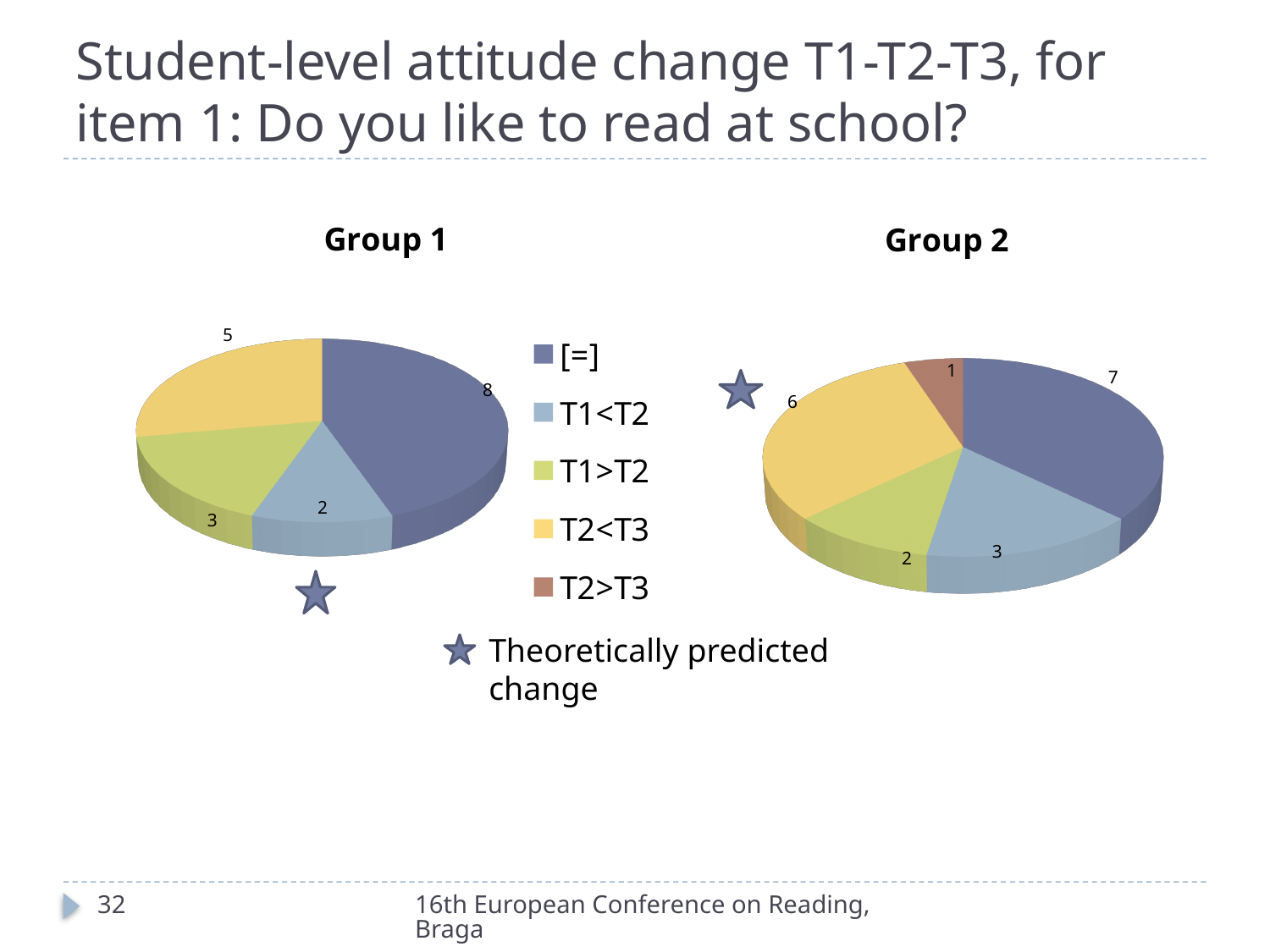
In the Group 1 chart, what is the value for T2<T3? 5 Which is larger: the T2<T3 value in Group 1 or the T2<T3 value in Group 2? Group 2 How many slices does the Group 2 pie chart have? 5 In the Group 2 chart, which category has the smallest slice? T2>T3 In the Group 2 chart, what is the value for T2>T3? 1 How many entries does the legend list? 5 In the Group 1 chart, which category has the smallest slice? T1<T2 In the Group 2 chart, which category has the largest slice? [=] In the Group 1 chart, what is the difference between the [=] value and the T2<T3 value? 3 What kind of chart is used for Group 1? pie chart In the Group 2 chart, what is the value for T1<T2? 3 In the Group 1 chart, what is the value for [=]? 8